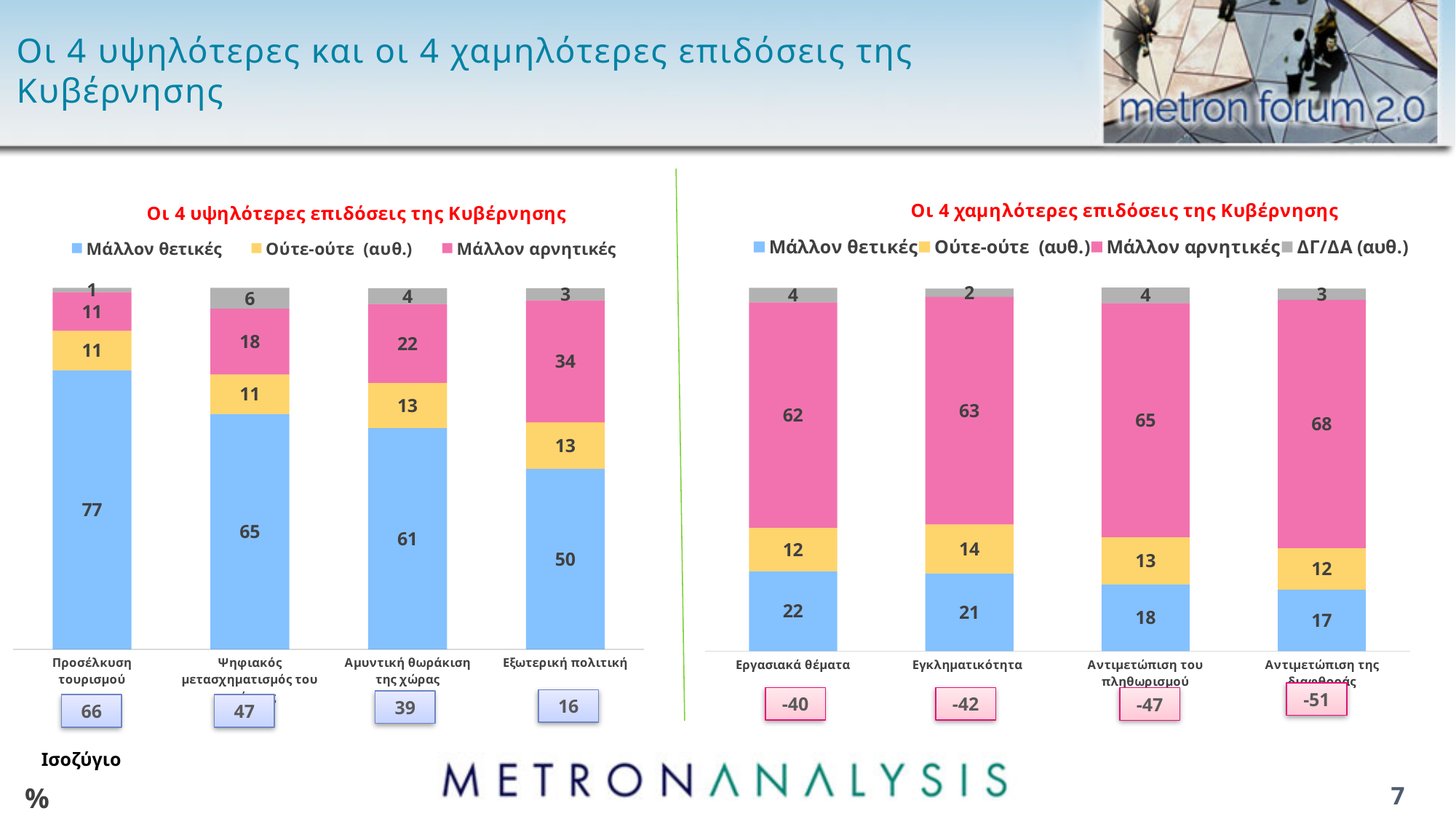
How many series does the legend of the chart 'Οι 4 χαμηλότερες επιδόσεις της Κυβέρνησης' list? 4 In the chart 'Οι 4 υψηλότερες επιδόσεις της Κυβέρνησης', what is the 'Μάλλον θετικές' value for 'Προσέλκυση τουρισμού'? 77 In the chart 'Οι 4 υψηλότερες επιδόσεις της Κυβέρνησης', what is the difference between the 'Μάλλον θετικές' values for 'Προσέλκυση τουρισμού' and 'Εξωτερική πολιτική'? 27 In the chart 'Οι 4 χαμηλότερες επιδόσεις της Κυβέρνησης', what is the 'Μάλλον αρνητικές' value for 'Αντιμετώπιση του πληθωρισμού'? 65 In the chart 'Οι 4 χαμηλότερες επιδόσεις της Κυβέρνησης', which category has the lowest 'Μάλλον θετικές' value? Αντιμετώπιση της διαφθοράς In the chart 'Οι 4 υψηλότερες επιδόσεις της Κυβέρνησης', which category has the highest 'Μάλλον αρνητικές' value? Εξωτερική πολιτική What kind of chart is 'Οι 4 χαμηλότερες επιδόσεις της Κυβέρνησης'? Stacked bar chart In the chart 'Οι 4 υψηλότερες επιδόσεις της Κυβέρνησης', do the 'Μάλλον θετικές' values rise or fall from left to right? Fall In the chart 'Οι 4 χαμηλότερες επιδόσεις της Κυβέρνησης', what is the total of the stacked bar for 'Εγκληματικότητα'? 100 In the chart 'Οι 4 υψηλότερες επιδόσεις της Κυβέρνησης', what colour represents the 'Μάλλον θετικές' series? Blue In the chart 'Οι 4 χαμηλότερες επιδόσεις της Κυβέρνησης', which is larger: the 'Ούτε-ούτε (αυθ.)' value for 'Εγκληματικότητα' or for 'Εργασιακά θέματα'? Εγκληματικότητα How many categories are shown in the chart 'Οι 4 υψηλότερες επιδόσεις της Κυβέρνησης'? 4